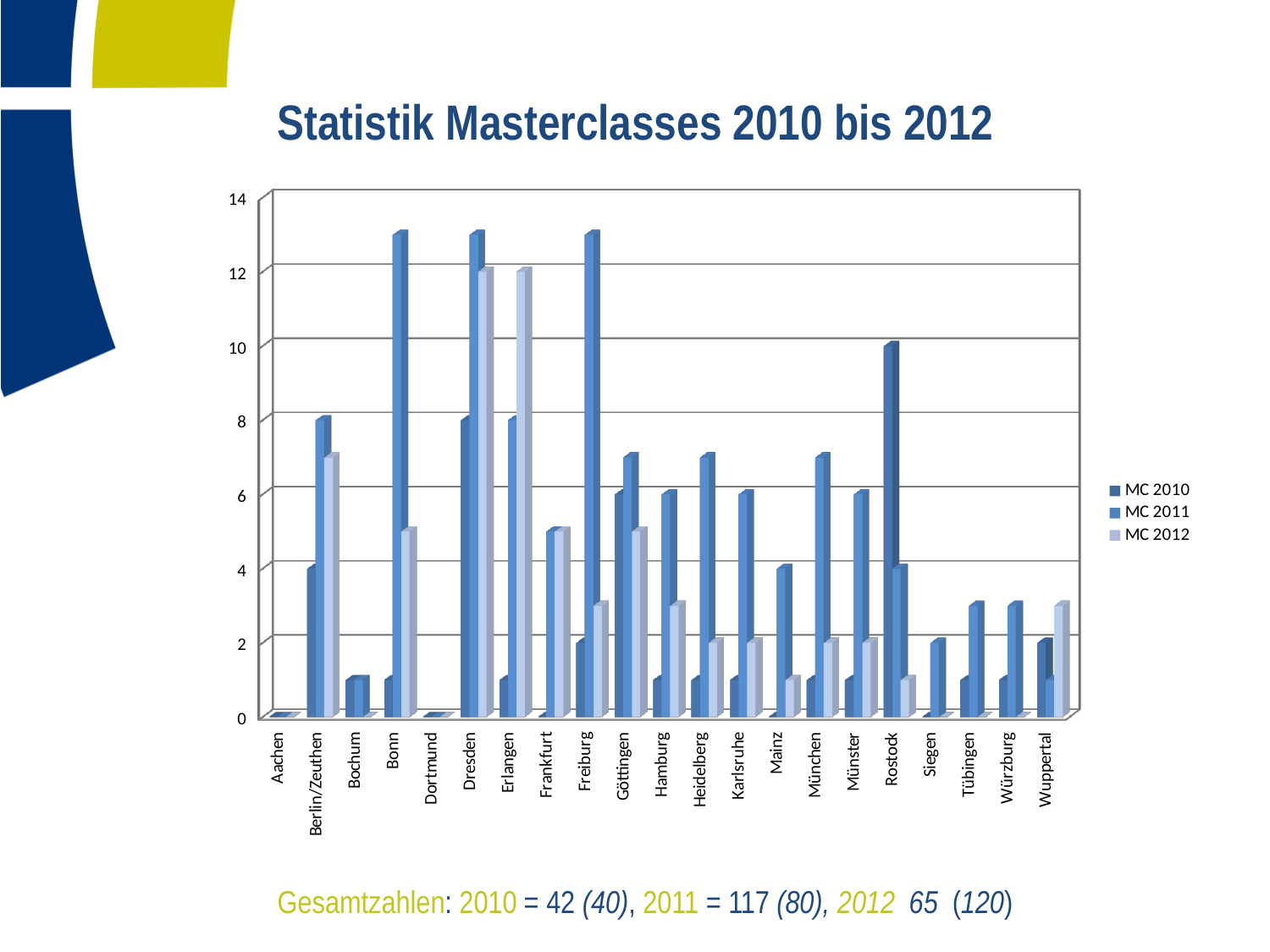
What is the title of the chart? Statistik Masterclasses 2010 bis 2012 Is the MC 2011 value for Bonn greater or less than 12? greater Which series is shown in the lightest blue in the legend? MC 2012 What kind of chart is shown on the slide? bar chart What is the MC 2010 value for Rostock? 10 For Dresden, which is larger: the MC 2010 value or the MC 2011 value? MC 2011 For Rostock, which is larger: the MC 2010 value or the MC 2011 value? MC 2010 Which city has the highest value for MC 2010? Rostock Is the MC 2012 value for Berlin/Zeuthen greater or less than 6? greater Is the MC 2011 value for Mainz greater or less than 6? less How many cities are shown on the x axis? 21 How many series does the legend list? 3